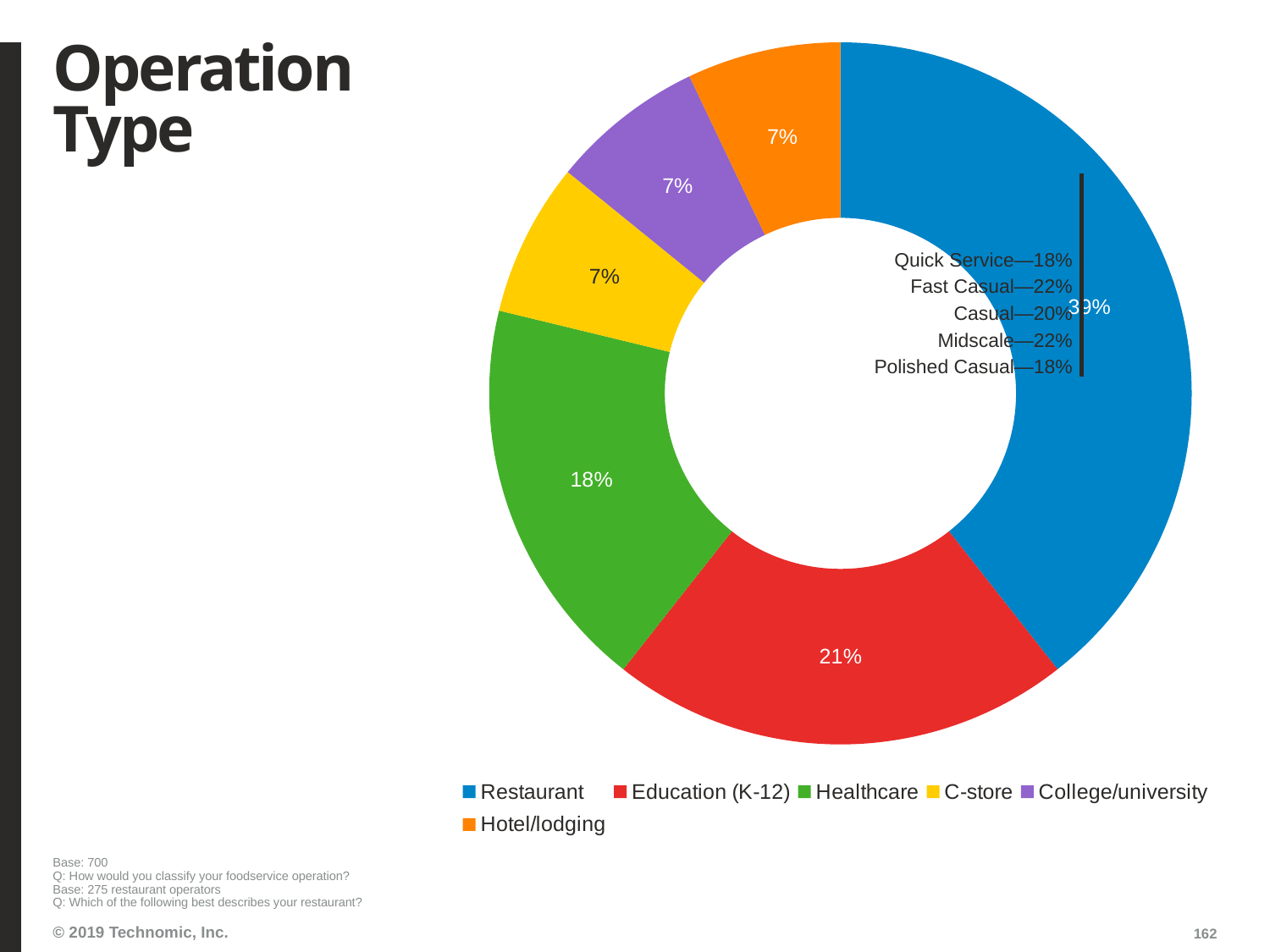
Which operation type has the largest share of the chart? Restaurant What is the combined share of Restaurant and Healthcare? 57% How many operation types does the legend list? 6 What kind of chart is shown on the slide? Donut (pie) chart What share of the chart is Education (K-12)? 21% What is the difference between the Restaurant share and the Education (K-12) share? 18 percentage points Which colour represents Hotel/lodging in the chart? Orange Which is larger, the Healthcare share or the Education (K-12) share? Education (K-12) What share of the chart is Healthcare? 18% What share of the chart is Restaurant? 39% What share of the chart is C-store? 7% What is the title of the slide containing the chart? Operation Type